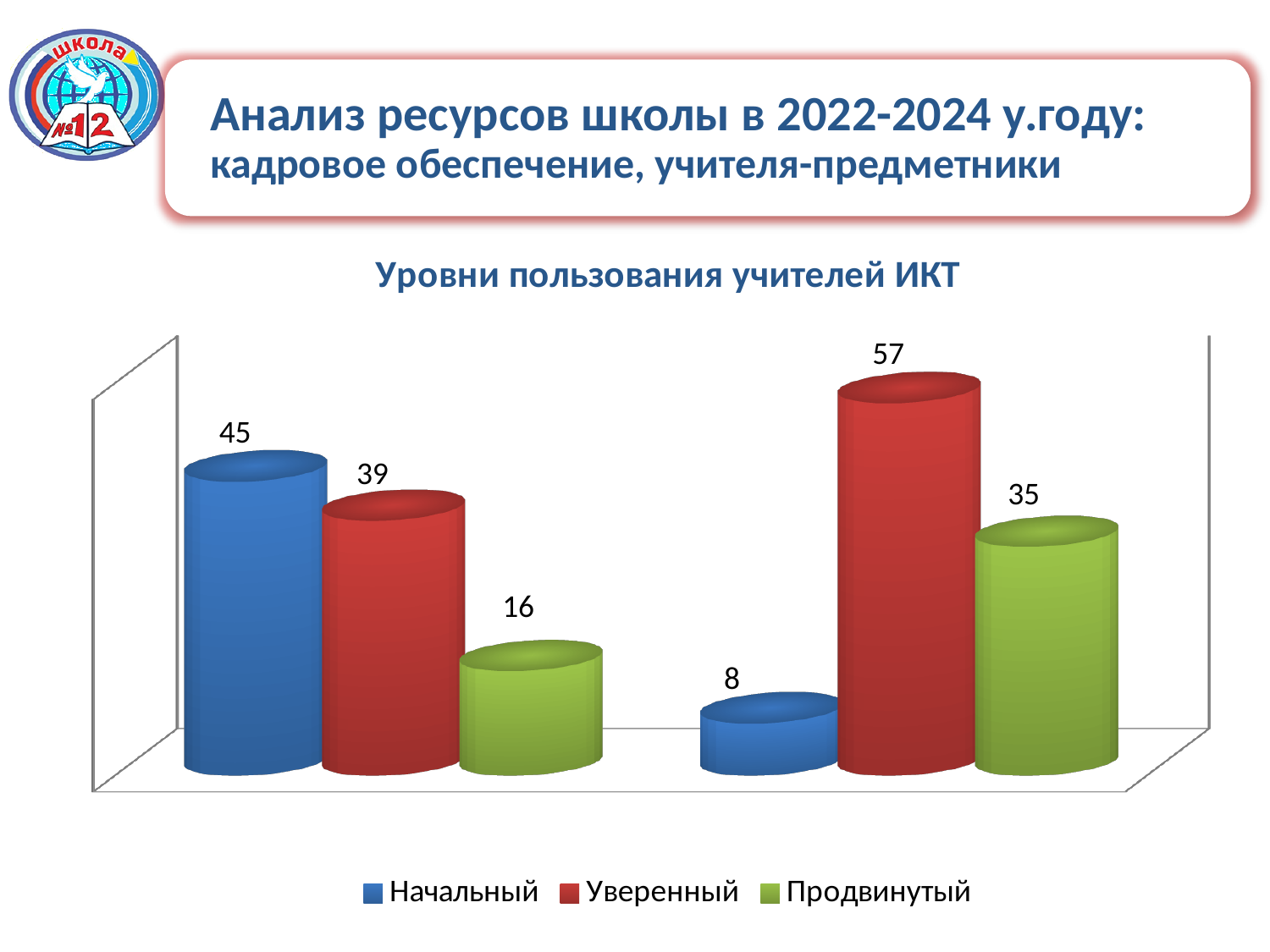
How many series does the legend list? 3 What is the difference between the Уверенный values in the right group and the left group? 18 What is the value of the Уверенный bar in the right group? 57 Which is larger: the Продвинутый value in the left group or in the right group? right group Which series has the lowest value in the left group? Продвинутый What type of chart is shown on the slide? bar chart Which series has the highest value in the right group? Уверенный What is the title of the chart? Уровни пользования учителей ИКТ What is the value of the Начальный bar in the right group? 8 How many groups of bars are shown in the chart? 2 What is the value of the Начальный bar in the left group? 45 What is the value of the Продвинутый bar in the left group? 16